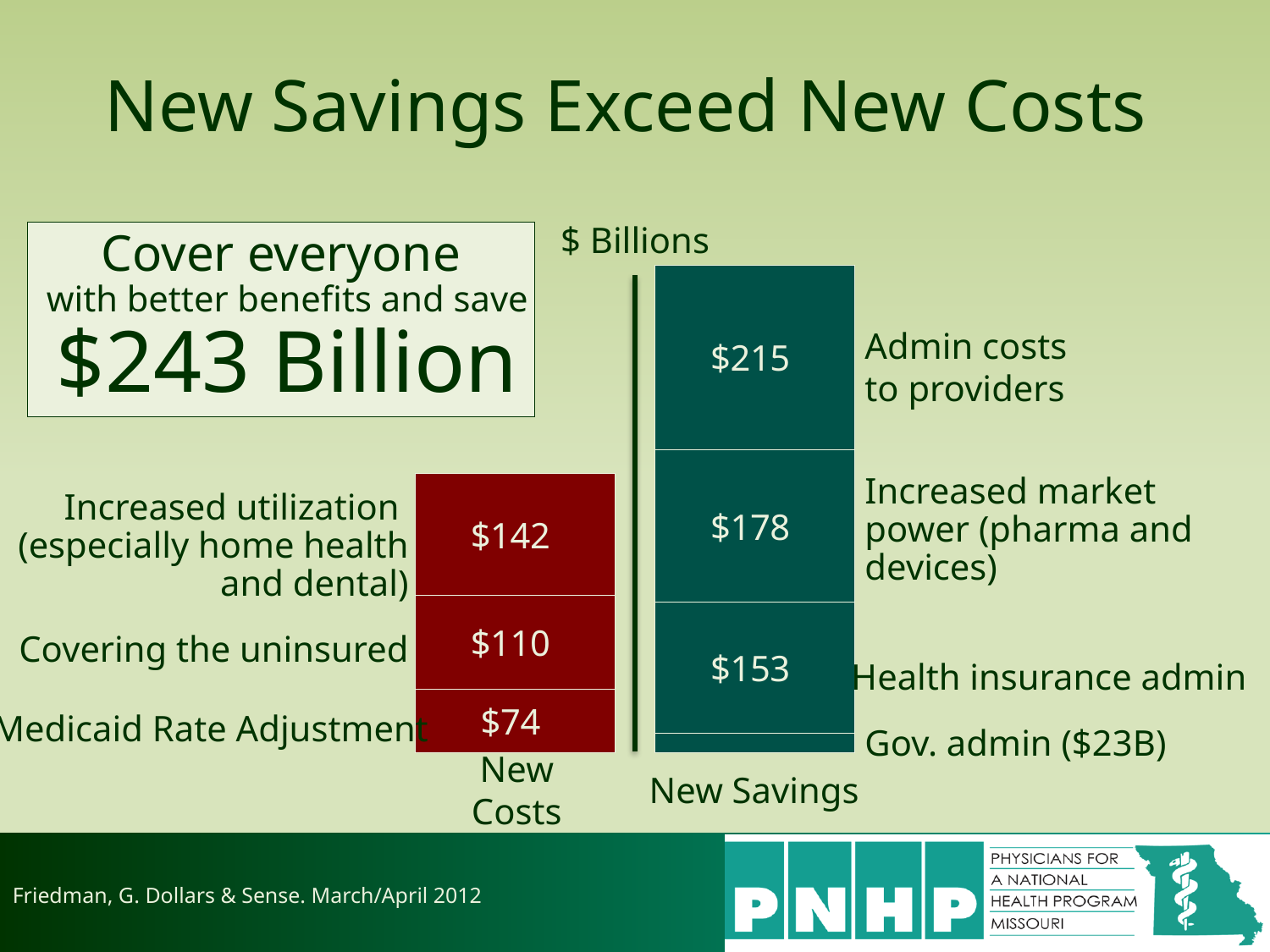
How many segments make up the New Costs bar? 3 What unit is shown above the chart? $ Billions What is the total of the New Costs bar? $326 What is the value of the Health insurance admin segment in the New Savings bar? $153 What is the difference between the Increased utilization segment ($142) and the Medicaid Rate Adjustment segment ($74)? $68 Which segment of the New Costs bar is the smallest? Medicaid Rate Adjustment Which segment of the New Savings bar is the largest? Admin costs to providers What is the value of the Increased utilization segment in the New Costs bar? $142 What is the value of the Admin costs to providers segment in the New Savings bar? $215 What type of chart is shown on the slide? Stacked bar chart Which is larger: the Increased market power segment or the Covering the uninsured segment? Increased market power What is the value of the Covering the uninsured segment? $110